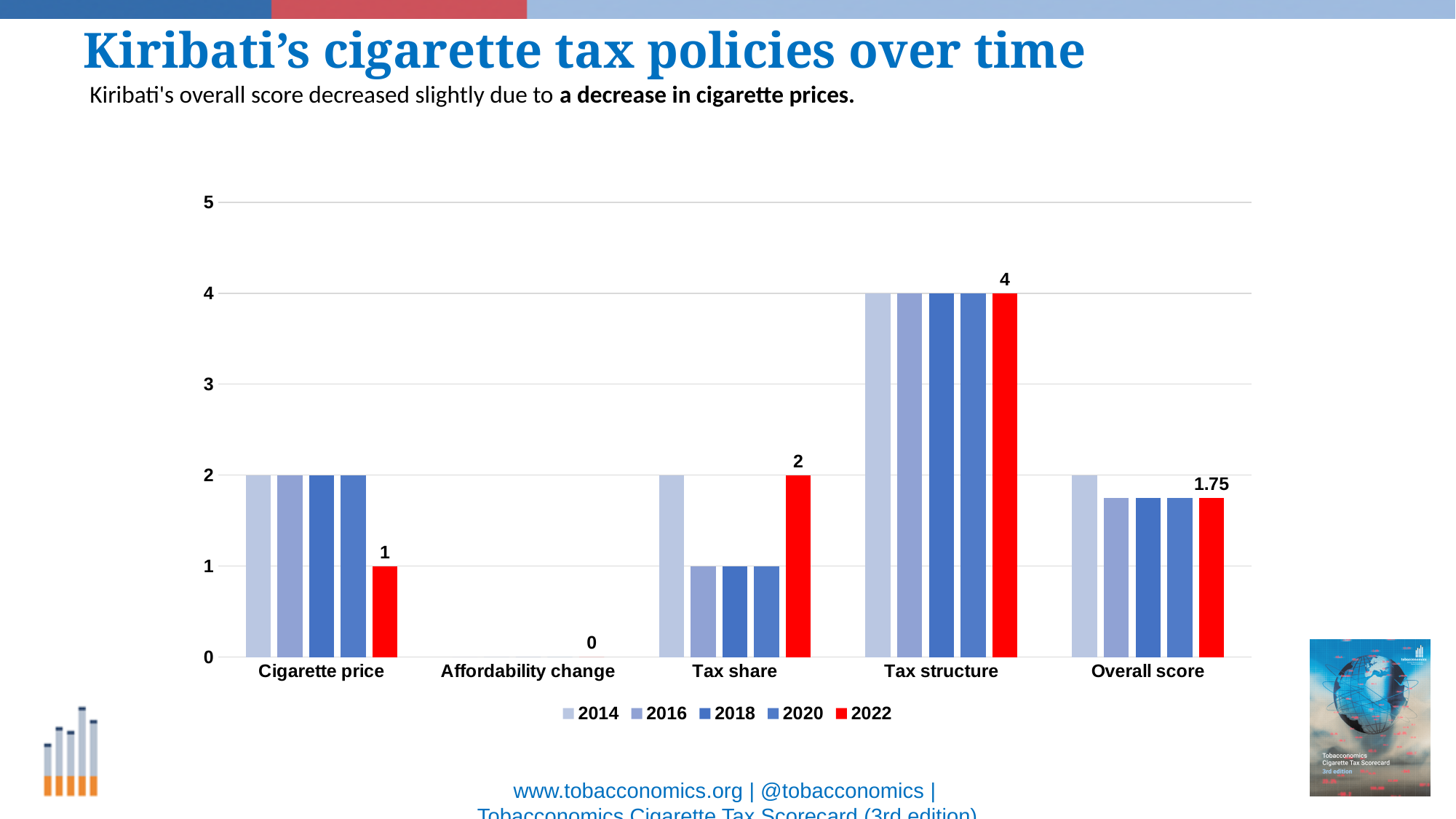
What kind of chart is shown on the slide? bar chart What is the difference between the 2022 values for Tax structure and Cigarette price? 3 What is the 2022 value for Cigarette price? 1 What is the 2022 value for Tax share? 2 Which category has the lowest 2022 value? Affordability change Is the 2022 value for Tax share larger or smaller than the 2022 value for Cigarette price? larger What is the 2022 value for Tax structure? 4 What is the 2022 value for Overall score? 1.75 What is the 2022 value for Affordability change? 0 How many series does the legend list? 5 Which category has the highest 2022 value? Tax structure How many categories are shown on the x axis? 5